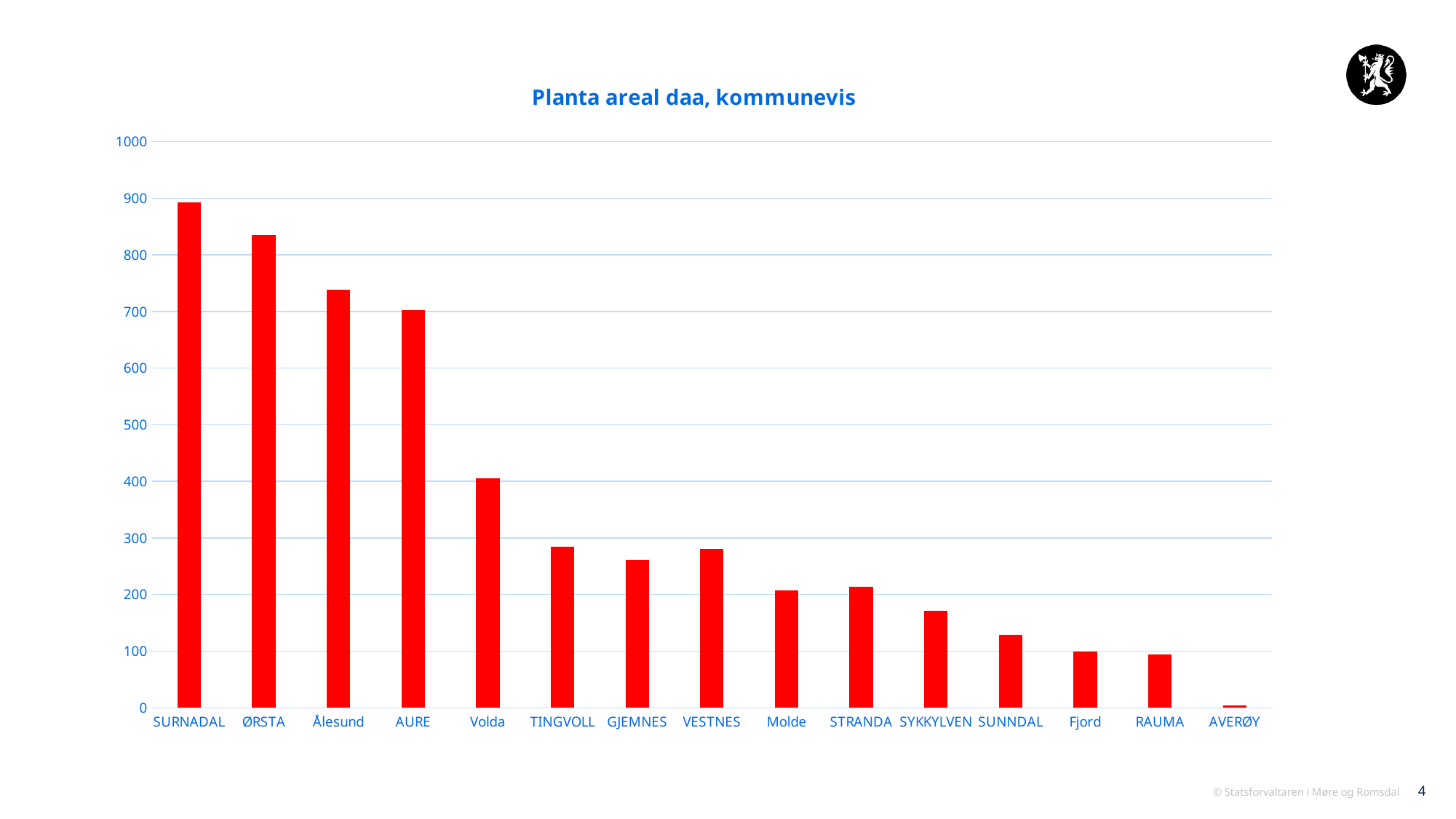
Do the bar values generally rise or fall from left to right along the x axis? fall Which has the larger value, SYKKYLVEN or SUNNDAL? SYKKYLVEN How many municipalities (categories) are shown on the x axis? 15 Is the value for TINGVOLL greater or less than 300? less Which has the larger value, Ålesund or Volda? Ålesund Which municipality has the lowest planted area? AVERØY What is the title of the chart? Planta areal daa, kommunevis Is the value for Volda greater or less than 500? less Is the value for SYKKYLVEN greater or less than 100? greater Which municipality has the highest planted area? SURNADAL What kind of chart is shown on the slide? Bar chart